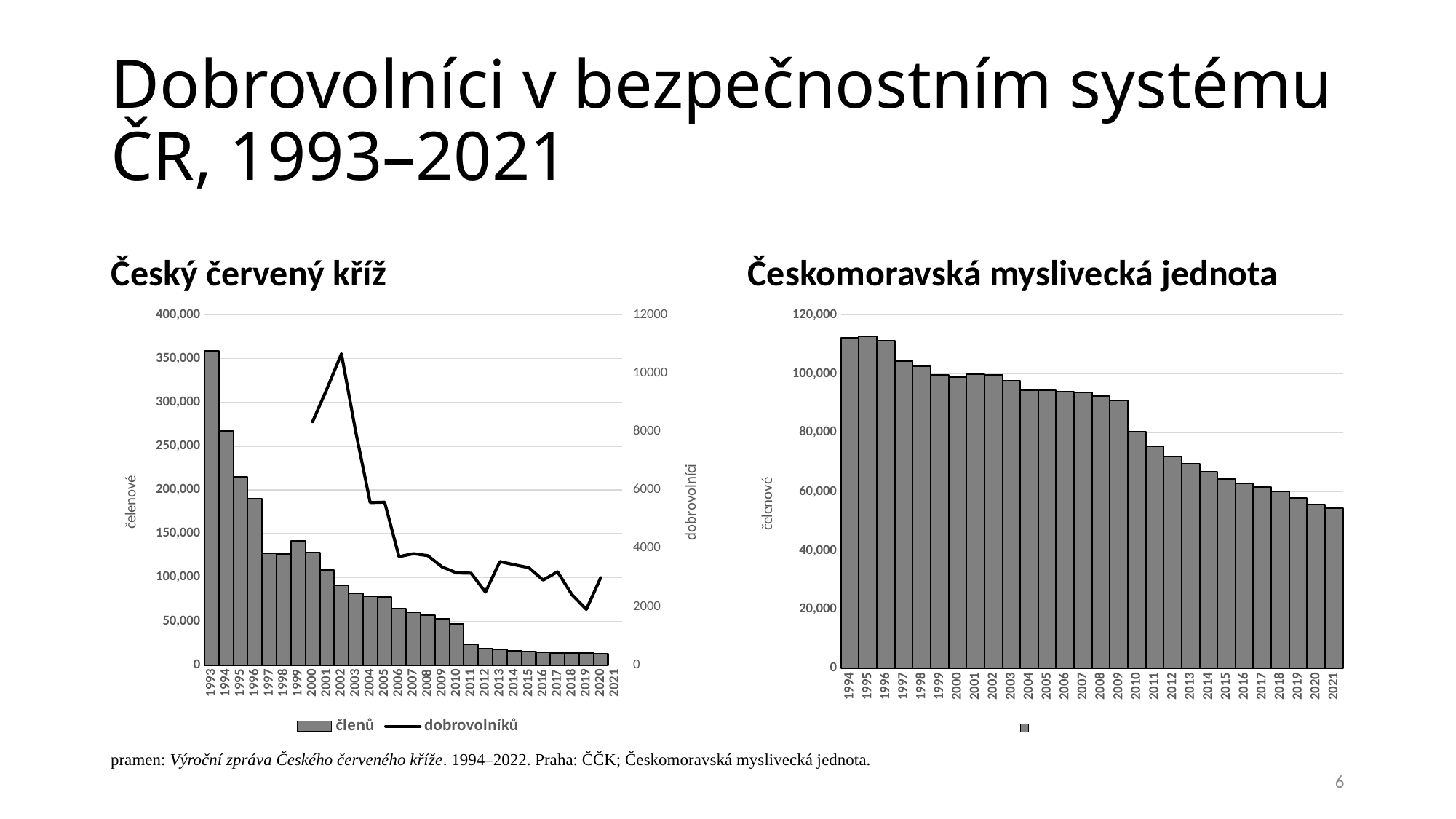
In the 'Českomoravská myslivecká jednota' chart, is the value for 2021 greater or less than 60,000? less In the 'Český červený kříž' chart, in which year does the dobrovolníků line reach its peak? 2002 In the 'Český červený kříž' chart, is the členů value for 1993 greater or less than 300,000? greater In the 'Český červený kříž' chart, is the dobrovolníků value for 2002 greater or less than 10000? greater In the 'Českomoravská myslivecká jednota' chart, do the values generally rise or fall from 1994 to 2021? fall How many series does the legend of the 'Český červený kříž' chart list? 2 In the 'Českomoravská myslivecká jednota' chart, which is larger, the value for 1997 or the value for 2017? 1997 What kind of chart is the 'Českomoravská myslivecká jednota' chart on the right? bar chart In the 'Český červený kříž' chart, which year has the highest bar for členů? 1993 How many years are shown on the x axis of the 'Českomoravská myslivecká jednota' chart? 28